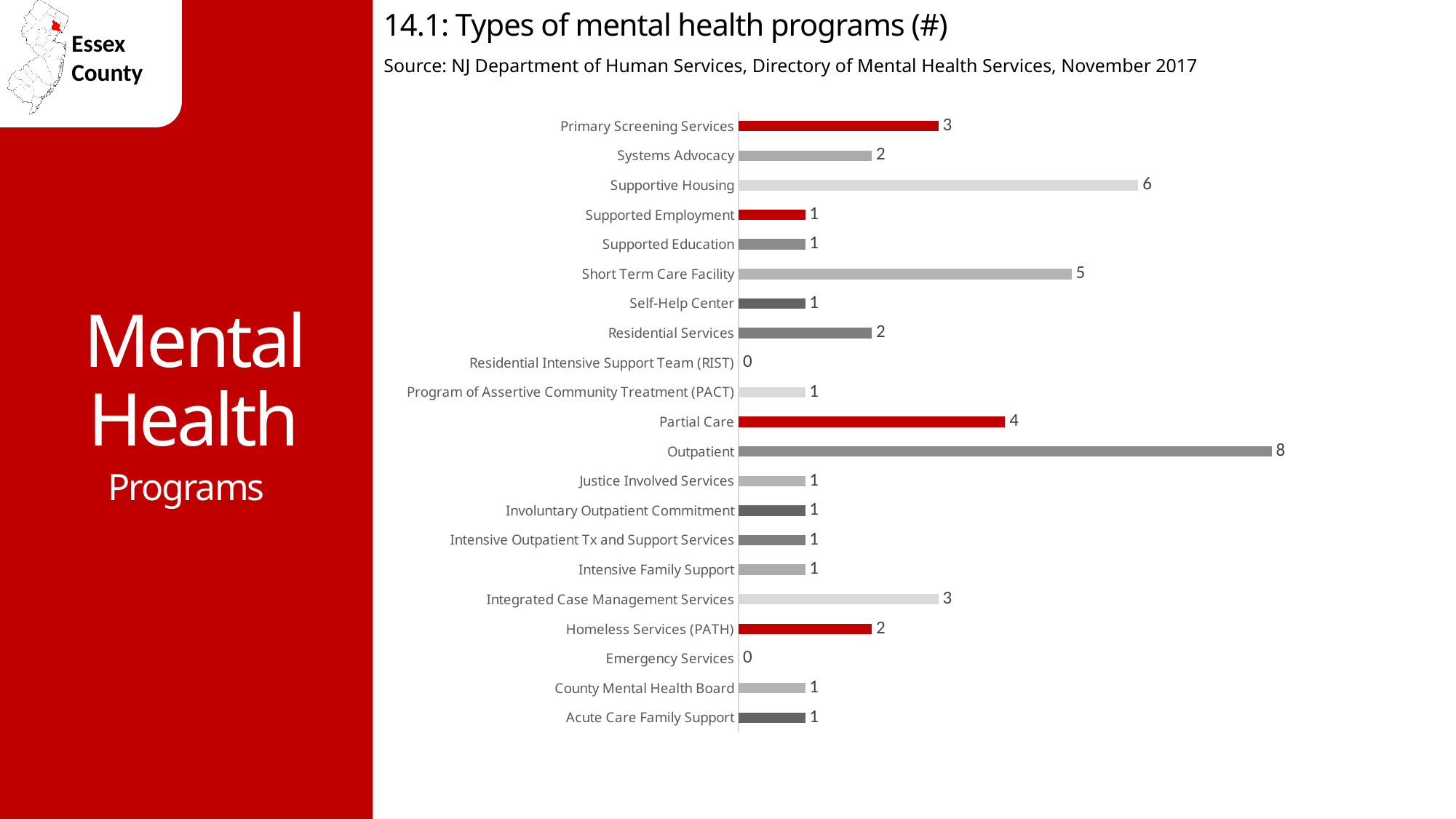
Which category has the highest value? Outpatient What is the difference between the values for Short Term Care Facility and Primary Screening Services? 2 What is the value for Partial Care? 4 What is the value for Outpatient? 8 How many categories are shown in the chart? 21 What is the value for Homeless Services (PATH)? 2 Which is larger, the value for Partial Care or the value for Residential Services? Partial Care What is the difference between the values for Outpatient and Supportive Housing? 2 What is the value for Supportive Housing? 6 What is the title of the chart? 14.1: Types of mental health programs (#) What is the value for Short Term Care Facility? 5 What kind of chart is shown on the slide? Bar chart